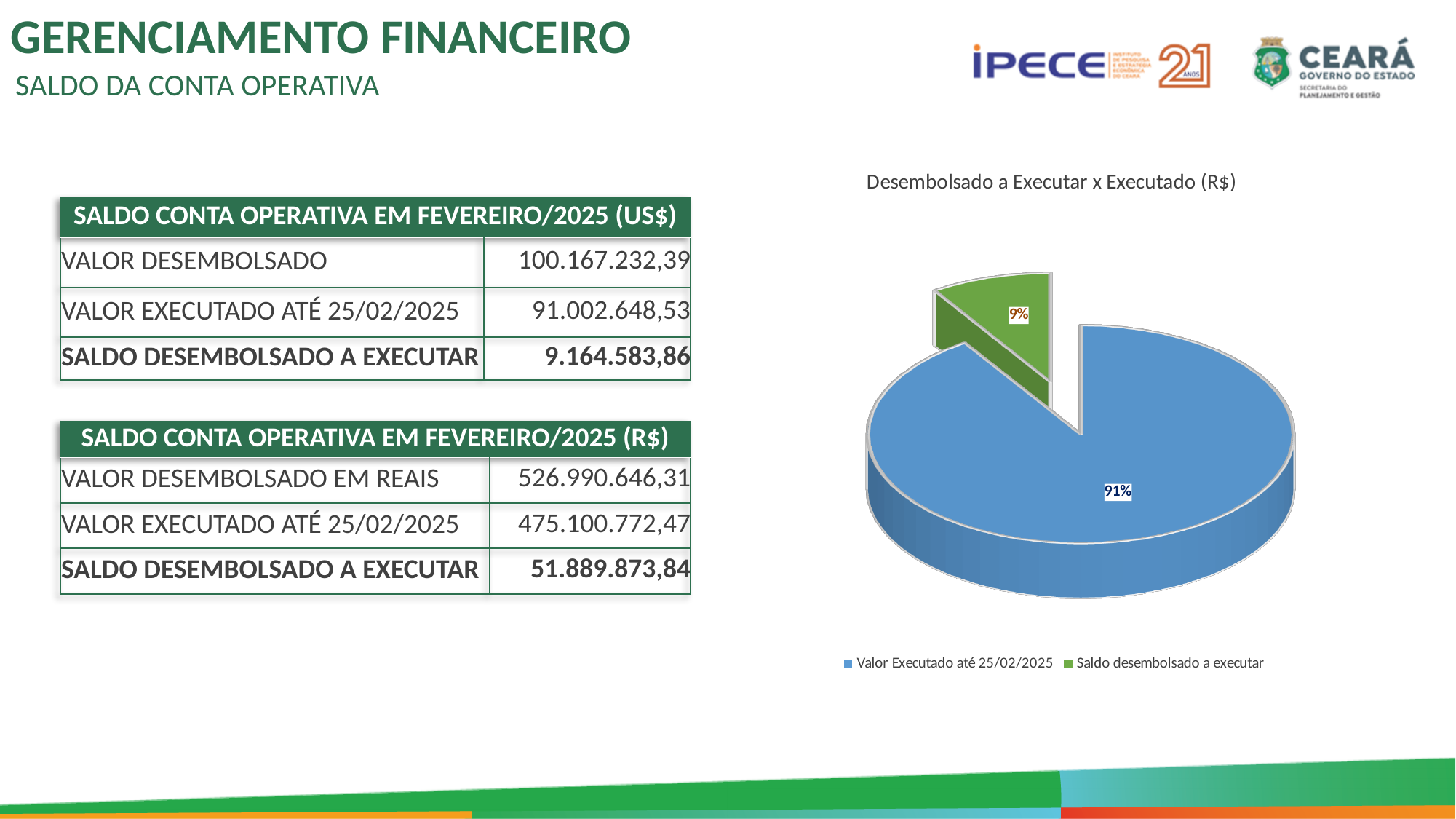
How many slices does the pie chart have? 2 What kind of chart is shown on the slide? Pie chart Which is larger in the pie chart: "Valor Executado até 25/02/2025" or "Saldo desembolsado a executar"? Valor Executado até 25/02/2025 What colour is the "Saldo desembolsado a executar" slice in the pie chart? Green Which slice of the pie chart is the smallest? Saldo desembolsado a executar Which slice of the pie chart is the largest? Valor Executado até 25/02/2025 What share of the pie chart does "Valor Executado até 25/02/2025" represent? 91% What is the title of the pie chart? Desembolsado a Executar x Executado (R$) How many entries does the legend of the pie chart list? 2 What share of the pie chart does "Saldo desembolsado a executar" represent? 9% By how many percentage points does the "Valor Executado até 25/02/2025" slice exceed the "Saldo desembolsado a executar" slice? 82 percentage points